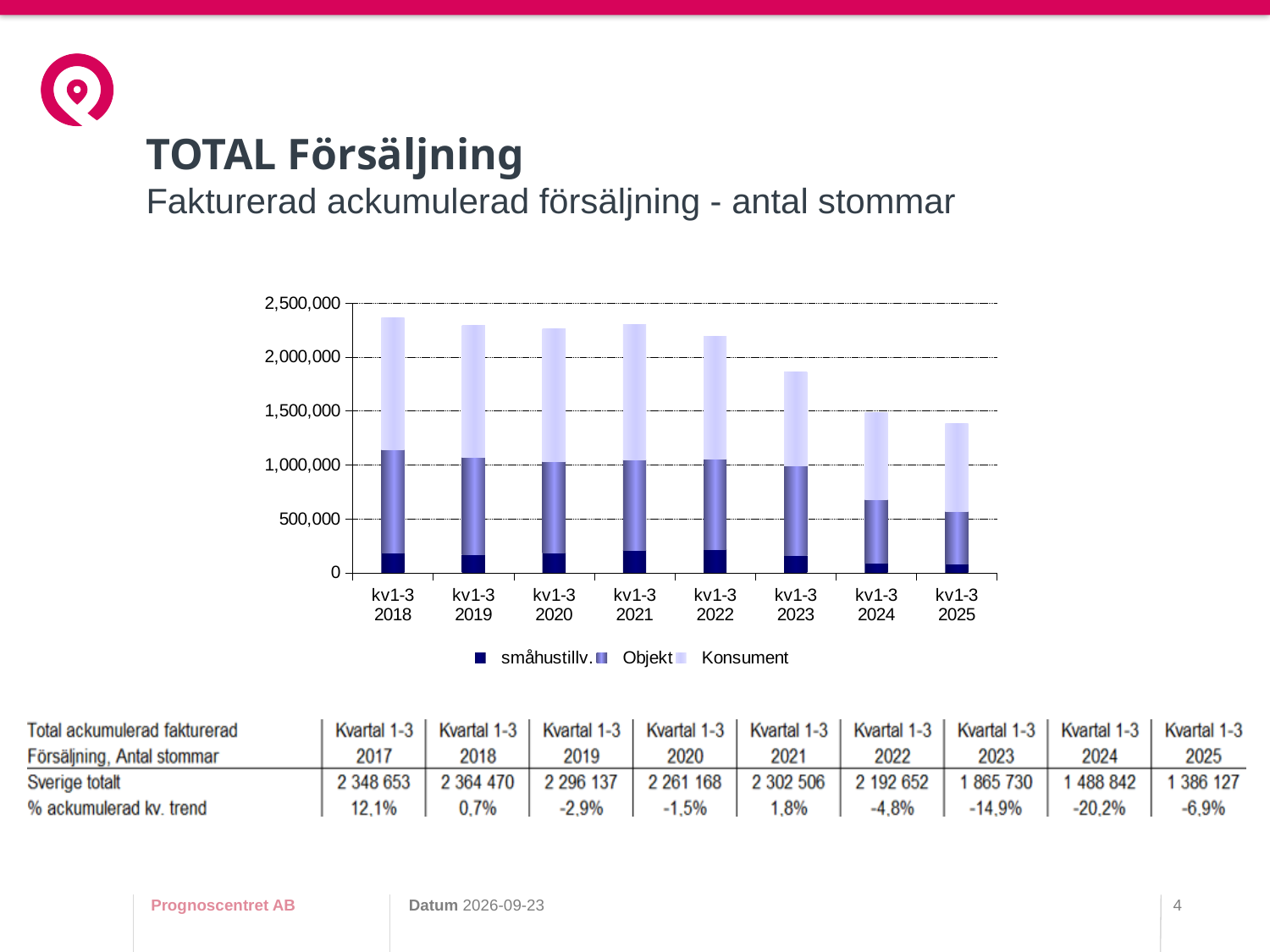
Which total bar is larger, kv1-3 2023 or kv1-3 2024? kv1-3 2023 How many periods (categories) are shown on the x axis of the chart? 8 According to the table below the chart, what is the Sverige totalt value for Kvartal 1-3 2024? 1 488 842 What kind of chart is shown on the slide? bar chart Do the total bars rise or fall from kv1-3 2022 to kv1-3 2025? fall Which period has the lowest total bar in the chart? kv1-3 2025 What are the three series named in the chart legend? småhustillv., Objekt, Konsument Is the total bar for kv1-3 2025 greater or less than 1,500,000? less Which period has the highest total bar in the chart? kv1-3 2018 How many series does the chart legend list? 3 Using the Sverige totalt values in the table, what is the difference between Kvartal 1-3 2018 and Kvartal 1-3 2025? 978 343 Is the total bar for kv1-3 2018 greater or less than 2,000,000? greater